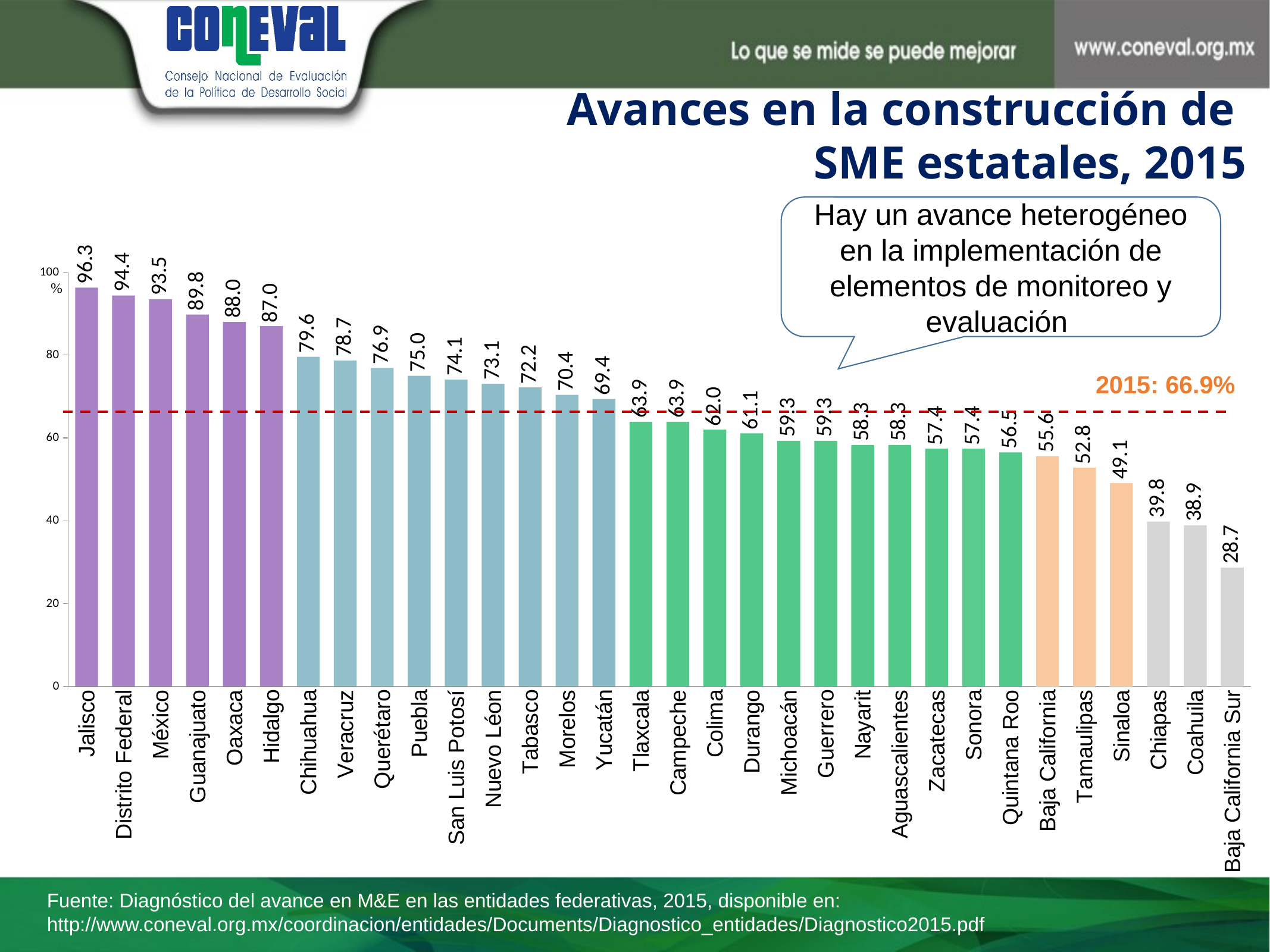
Which state has the lowest value? Baja California Sur What is the value for Chihuahua? 79.6 What is the difference between the values for Hidalgo and Chihuahua? 7.4 How many states are shown on the chart? 32 Which has a larger value, Veracruz or Tlaxcala? Veracruz What is the value for Jalisco? 96.3 Is the value for Sinaloa greater or less than 60? less What kind of chart is shown on the slide? bar chart What is the value for Quintana Roo? 56.5 What is the difference between the values for Jalisco and Baja California Sur? 67.6 Which state has the highest value? Jalisco What value does the dashed horizontal reference line represent, according to its label? 2015: 66.9%